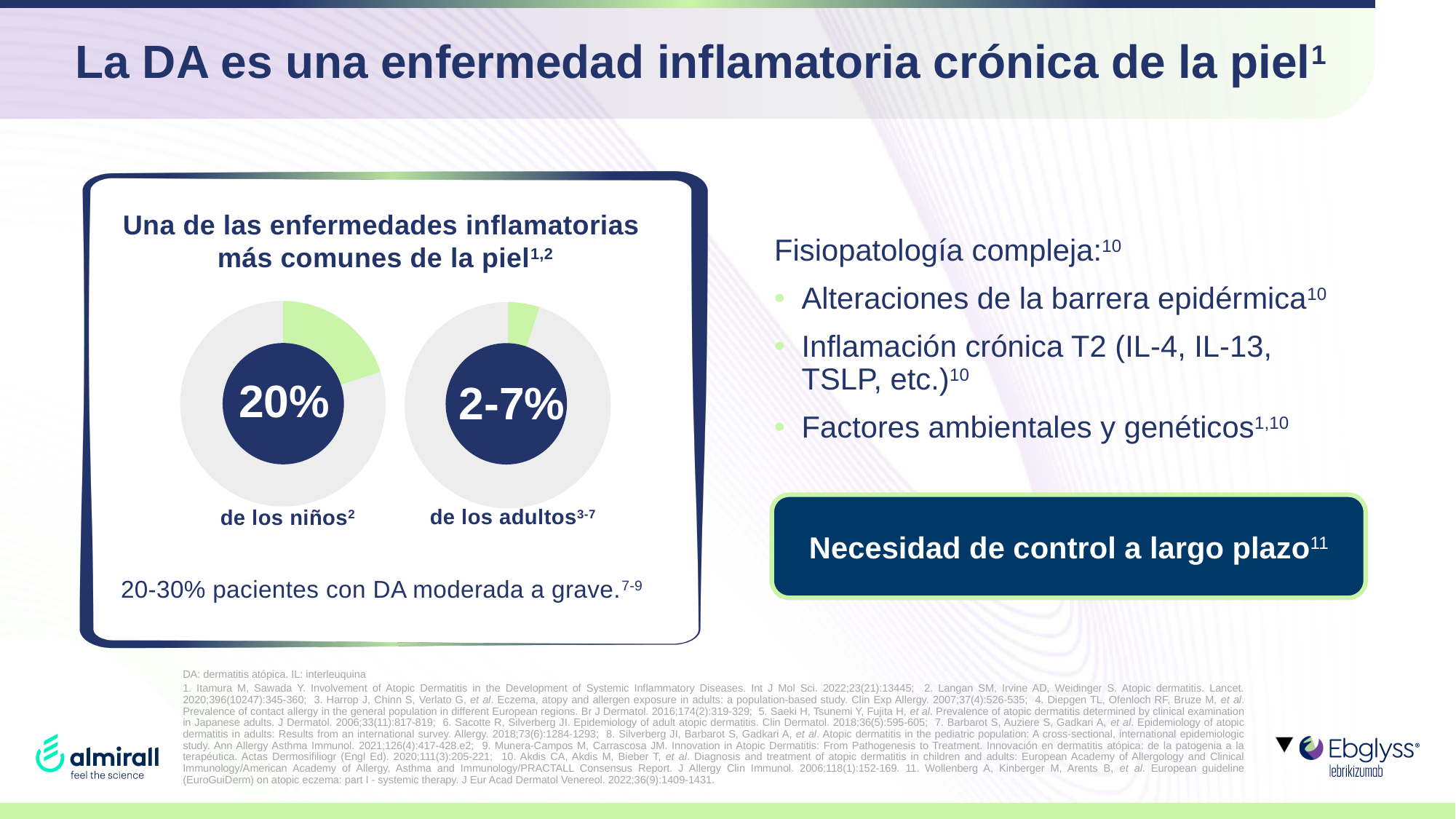
What colour is used for the highlighted segment in both donut charts? Green Which of the two donut charts shows the smaller highlighted segment? de los adultos Which of the two donut charts shows the larger highlighted segment? de los niños What kind of charts are shown inside the box on the left of the slide? Donut (pie) charts What is the title printed above the two donut charts? Una de las enfermedades inflamatorias más comunes de la piel On the right donut chart, what value is shown for 'de los adultos'? 2-7% Which group has the larger highlighted share, 'de los niños' or 'de los adultos'? de los niños How many donut charts are shown on the slide? 2 On the left donut chart, what share of the ring is highlighted in green for children? 20% On the left donut chart, what percentage is shown for 'de los niños'? 20%